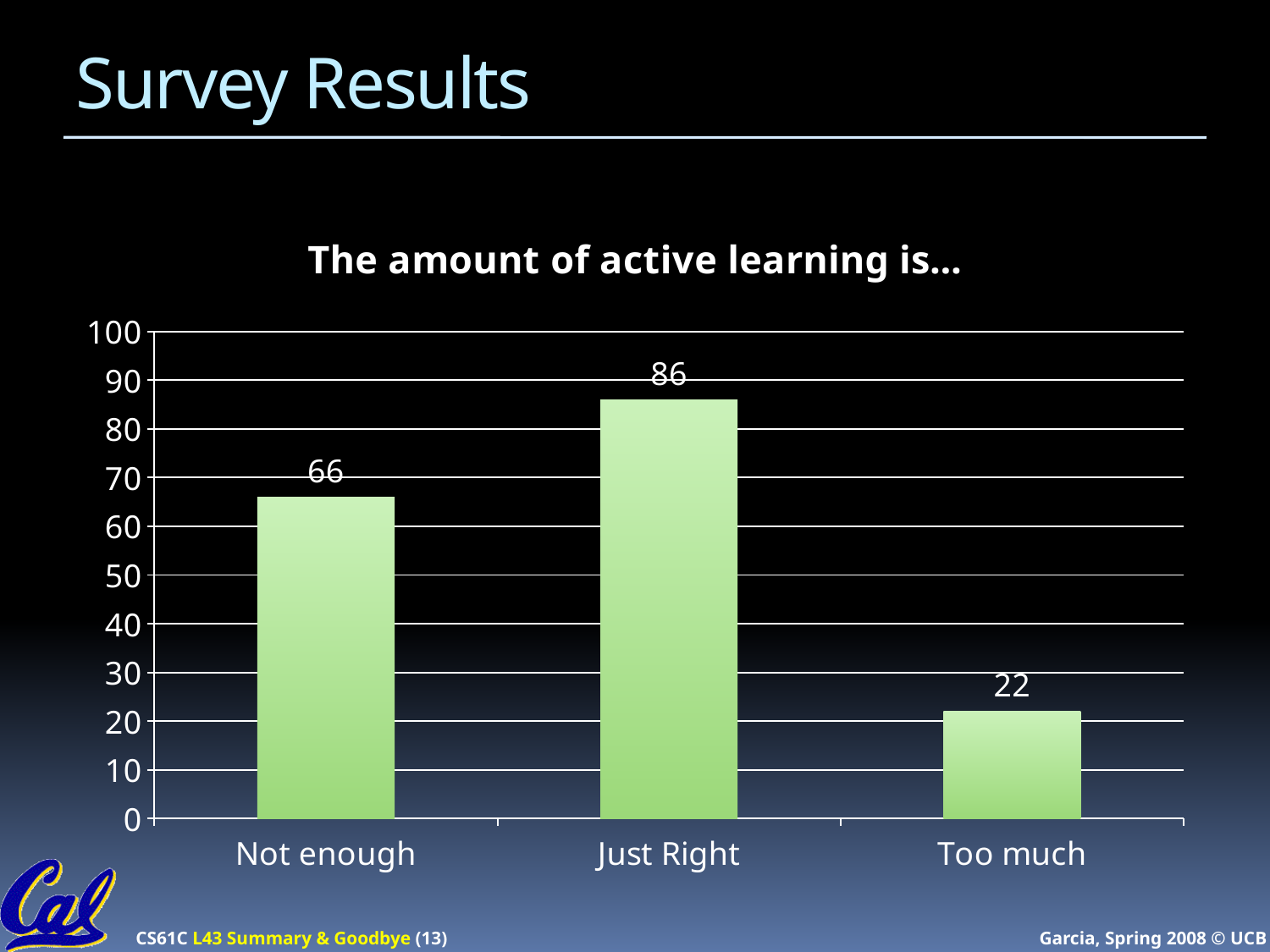
Which is larger, the value for "Not enough" or the value for "Too much"? Not enough What is the difference between the values for "Just Right" and "Not enough"? 20 What is the value for "Not enough"? 66 What kind of chart is shown on the slide? bar chart How many categories are shown on the x axis? 3 What is the title of the chart? The amount of active learning is… Which category has the lowest value? Too much What is the difference between the values for "Not enough" and "Too much"? 44 What is the value for "Too much"? 22 What is the value for "Just Right"? 86 Is the value for "Just Right" greater or less than 80? greater Which category has the highest value? Just Right